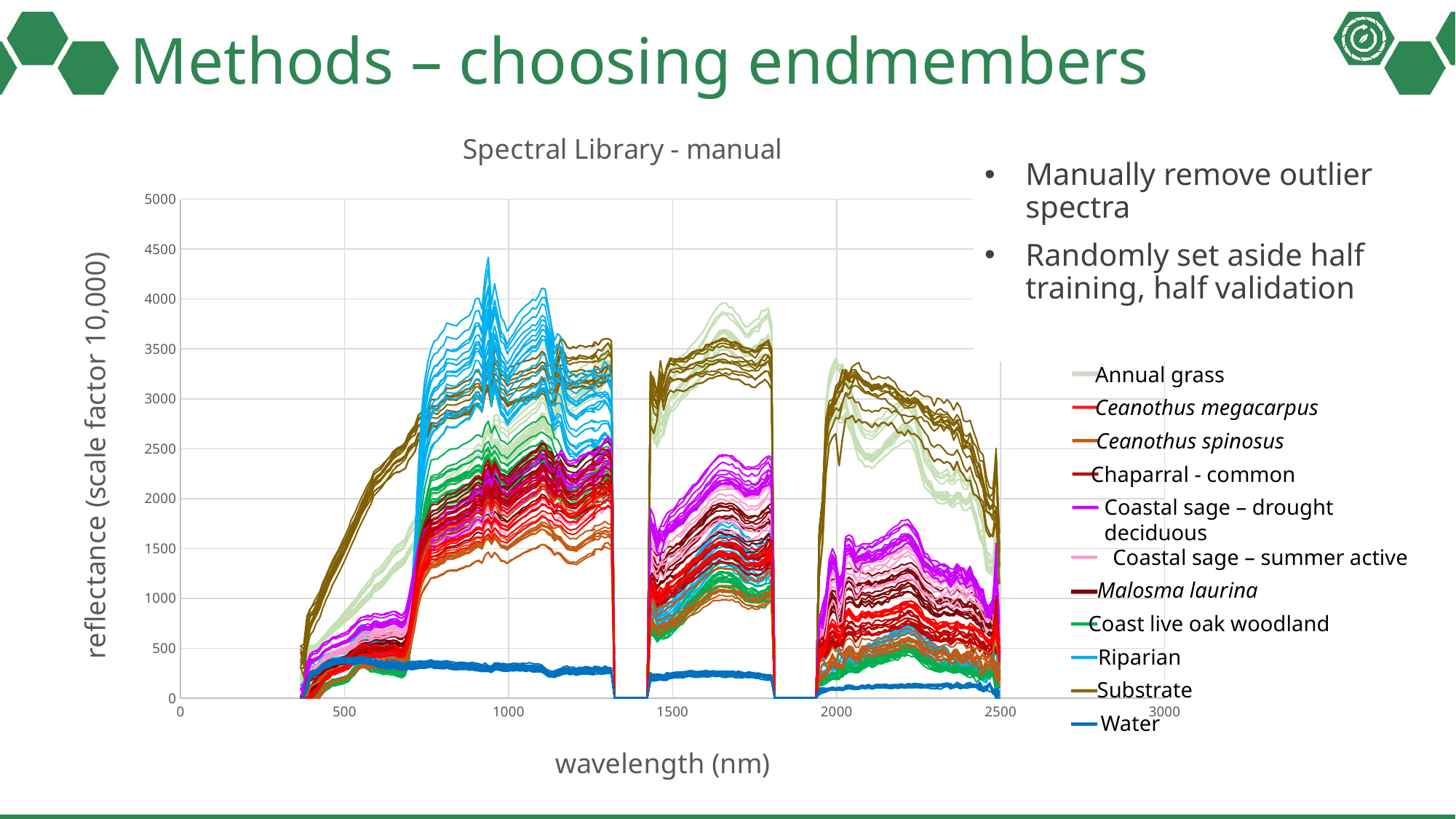
Which class has the lowest reflectance across the whole wavelength range? Water What is the title of the chart? Spectral Library - manual How many classes does the chart's legend list? 11 Is the reflectance of Annual grass around 1650 nm greater or less than 3500? greater What kind of chart is shown on the slide? line chart Around 1000 nm, which class has higher reflectance, Riparian or Water? Riparian Is the peak reflectance of Riparian greater or less than 4000? greater Which class reaches the highest reflectance value anywhere on the chart? Riparian Around 2000 nm, which class has higher reflectance, Substrate or Coast live oak woodland? Substrate What is the highest value shown on the y axis? 5000 What is the label of the x axis? wavelength (nm) Is the reflectance of Water at 1000 nm greater or less than 500? less